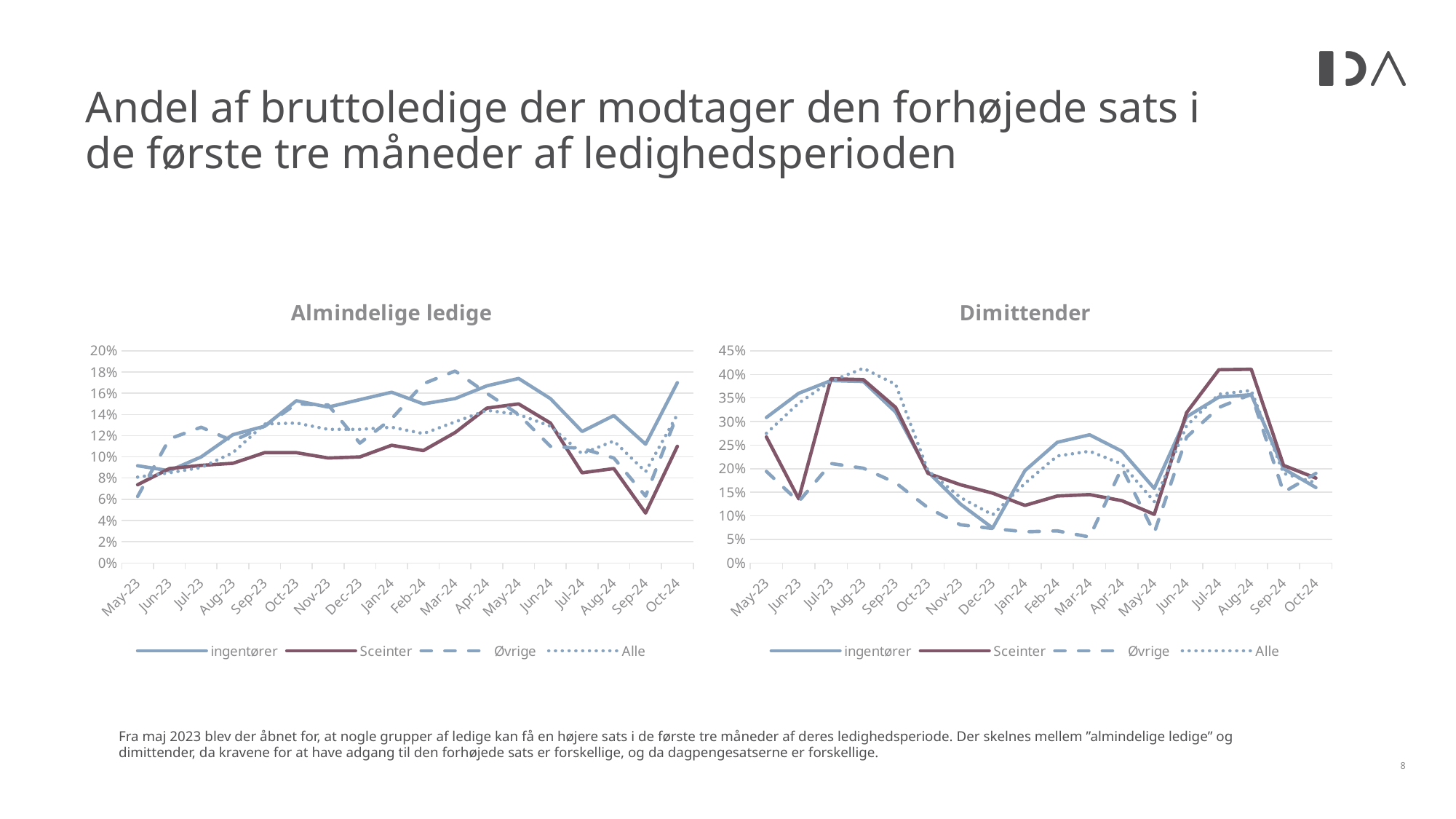
In the "Almindelige ledige" chart, is the value for ingeniører in May-24 greater or less than 16%? greater In the "Almindelige ledige" chart, does the Sceinter line rise or fall from May-23 to Oct-23? rise How many series does the legend of the "Dimittender" chart list? 4 In the "Dimittender" chart, is the value for Sceinter in Jul-24 greater or less than 40%? greater How many months are shown on the x axis of the "Almindelige ledige" chart? 18 In the "Almindelige ledige" chart, which series is higher in Oct-24, ingeniører or Sceinter? ingeniører In the "Dimittender" chart, is the value for ingeniører in Dec-23 greater or less than 10%? less What kind of chart is the "Almindelige ledige" chart? line chart In the "Dimittender" chart, does the ingeniører line rise or fall from Aug-23 to Dec-23? fall What is the highest value shown on the y axis of the "Dimittender" chart? 45% In the "Dimittender" chart, which series is higher in Jul-24, Sceinter or ingeniører? Sceinter